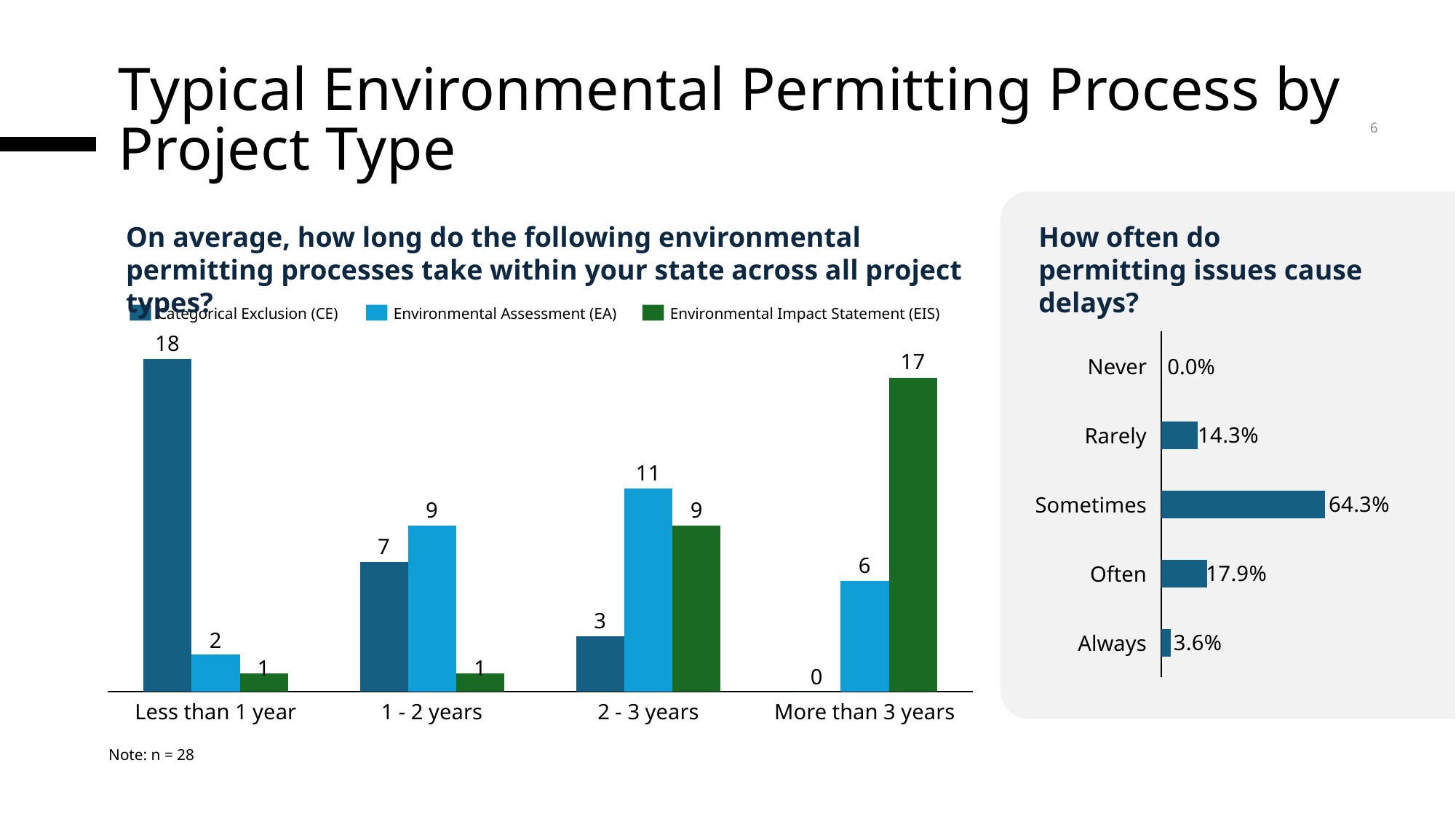
What kind of chart is the right chart 'How often do permitting issues cause delays?'? Bar chart In the right chart 'How often do permitting issues cause delays?', which category has the lowest value? Never In the left chart on permitting process duration, what is the value for Environmental Impact Statement (EIS) in the 'More than 3 years' category? 17 In the left chart on permitting process duration, which category has the highest value for Environmental Assessment (EA)? 2 - 3 years In the left chart on permitting process duration, how many categories are shown on the x axis? 4 In the left chart on permitting process duration, how many series does the legend list? 3 In the left chart on permitting process duration, what is the value for Categorical Exclusion (CE) in the 'Less than 1 year' category? 18 In the left chart on permitting process duration, which is larger in the '1 - 2 years' category: the CE value or the EA value? Environmental Assessment (EA) In the right chart 'How often do permitting issues cause delays?', what is the value for Sometimes? 64.3% In the left chart on permitting process duration, which category has the lowest value for Categorical Exclusion (CE)? More than 3 years In the left chart on permitting process duration, what is the difference between the EIS value and the EA value in the 'More than 3 years' category? 11 In the left chart on permitting process duration, what is the value for Environmental Assessment (EA) in the '2 - 3 years' category? 11